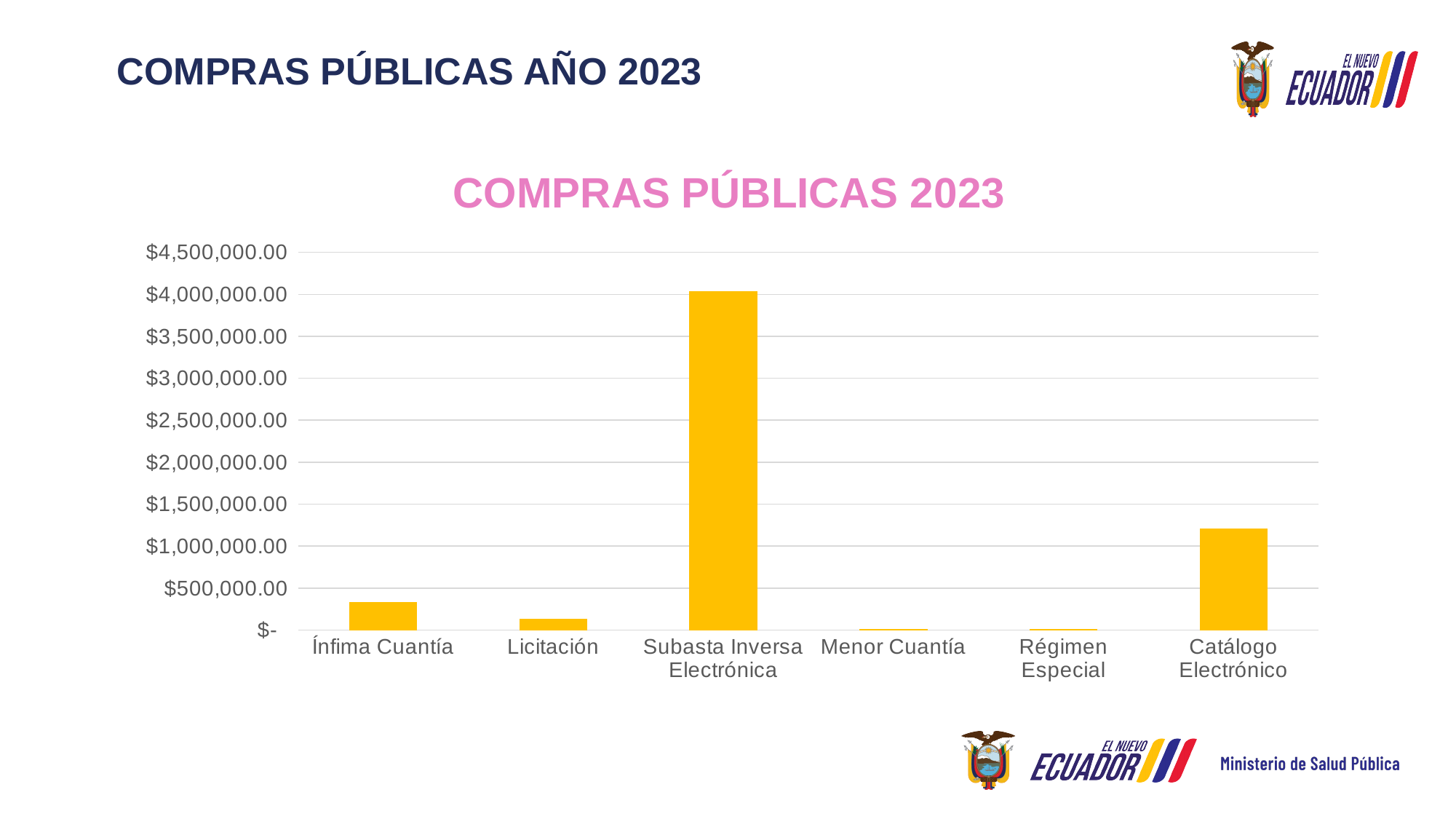
Which is larger, the value for Catálogo Electrónico or the value for Ínfima Cuantía? Catálogo Electrónico Is the value for Licitación greater or less than $500,000.00? less How many categories are shown on the x axis of the chart? 6 Is the value for Ínfima Cuantía greater or less than $500,000.00? less What colour are the bars in the chart? yellow Which is larger, the value for Ínfima Cuantía or the value for Licitación? Ínfima Cuantía Which category has the highest value in the chart? Subasta Inversa Electrónica Is the value for Catálogo Electrónico greater or less than $1,000,000.00? greater What is the title of the chart? COMPRAS PÚBLICAS 2023 What kind of chart is shown on the slide? bar chart